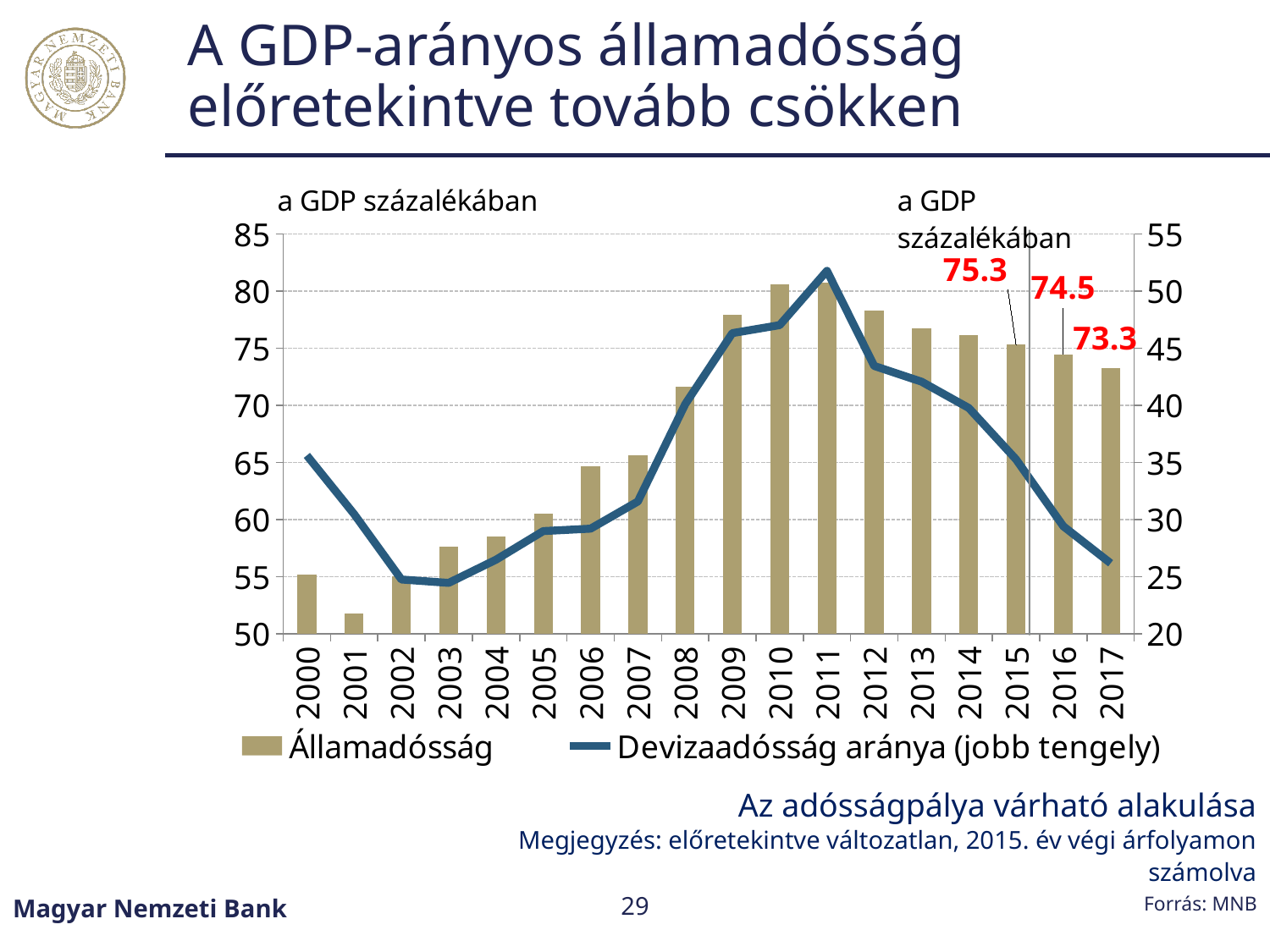
How many series does the legend list? 2 How many years are shown on the x axis? 18 What is the value of Államadósság for 2016? 74.5 What is the difference between the Államadósság values for 2015 and 2017? 2.0 What is the value of Államadósság for 2015? 75.3 Is the Államadósság value for 2008 greater or less than 70? greater Does the Devizaadósság aránya line rise or fall from 2011 to 2017? Fall Which year has the lowest Államadósság bar? 2001 What kind of chart is shown on the slide? Combined bar and line chart What is the value of Államadósság for 2017? 73.3 Is the Devizaadósság aránya value for 2011 greater or less than 50 on the right axis? greater Which year has the highest Államadósság bar? 2011